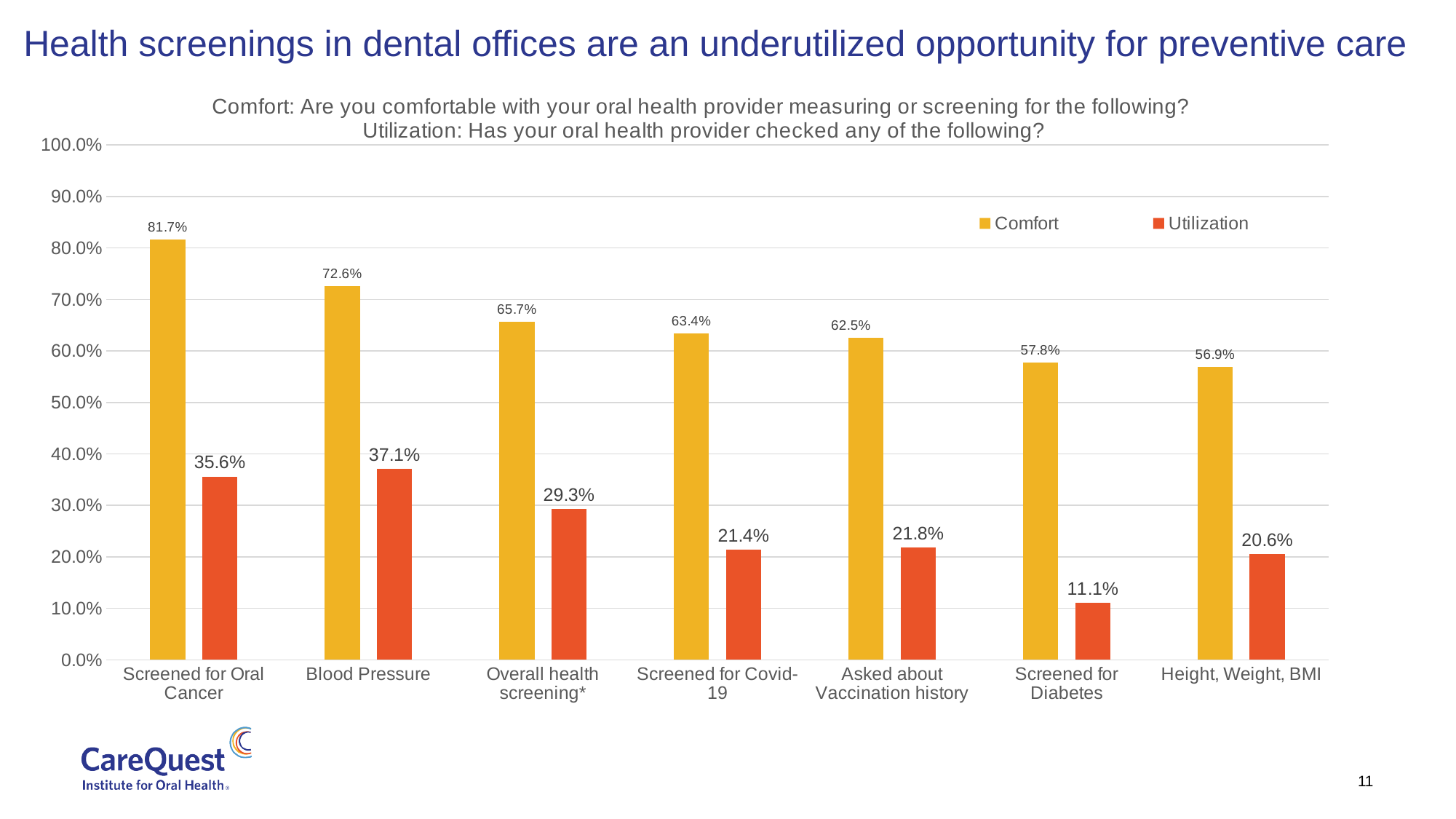
What is the difference between the Comfort and Utilization values for Screened for Oral Cancer? 46.1% Which category has the highest Comfort value? Screened for Oral Cancer How many series does the legend list? 2 What is the Utilization value for Screened for Diabetes? 11.1% What is the Comfort value for Blood Pressure? 72.6% What is the Utilization value for Height, Weight, BMI? 20.6% Which is larger, the Utilization value for Blood Pressure or the Utilization value for Overall health screening*? Blood Pressure Which category has the lowest Utilization value? Screened for Diabetes What kind of chart is shown on the slide? bar chart Which colour represents the Utilization series? Red/orange Is the Comfort value for Screened for Covid-19 greater or less than 60.0%? greater How many categories are shown on the x axis? 7